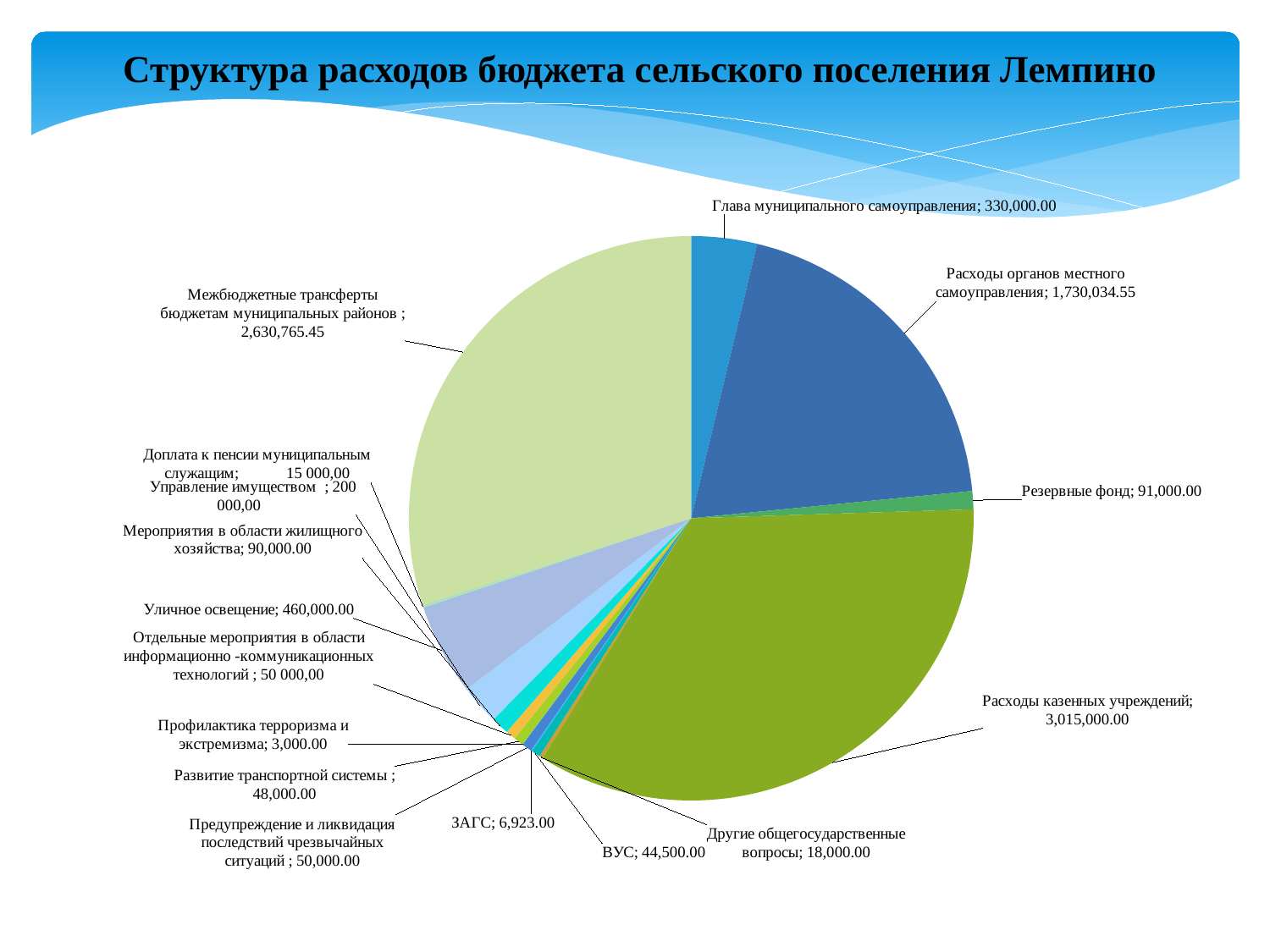
What is the value for Межбюджетные трансферты бюджетам муниципальных районов? 2,630,765.45 What is the difference between Глава муниципального самоуправления and Резервные фонд? 239,000.00 What kind of chart is shown on the slide? Pie chart Which category has the smallest value? Профилактика терроризма и экстремизма What is the value for Уличное освещение? 460,000.00 Which is larger: Уличное освещение or Глава муниципального самоуправления? Уличное освещение What is the title of the chart? Структура расходов бюджета сельского поселения Лемпино What is the value for ЗАГС? 6,923.00 What is the value for Расходы казенных учреждений? 3,015,000.00 What is the difference between Расходы казенных учреждений and Межбюджетные трансферты бюджетам муниципальных районов? 384,234.55 How many categories are shown in the pie chart? 16 Which category has the largest slice of the pie? Расходы казенных учреждений